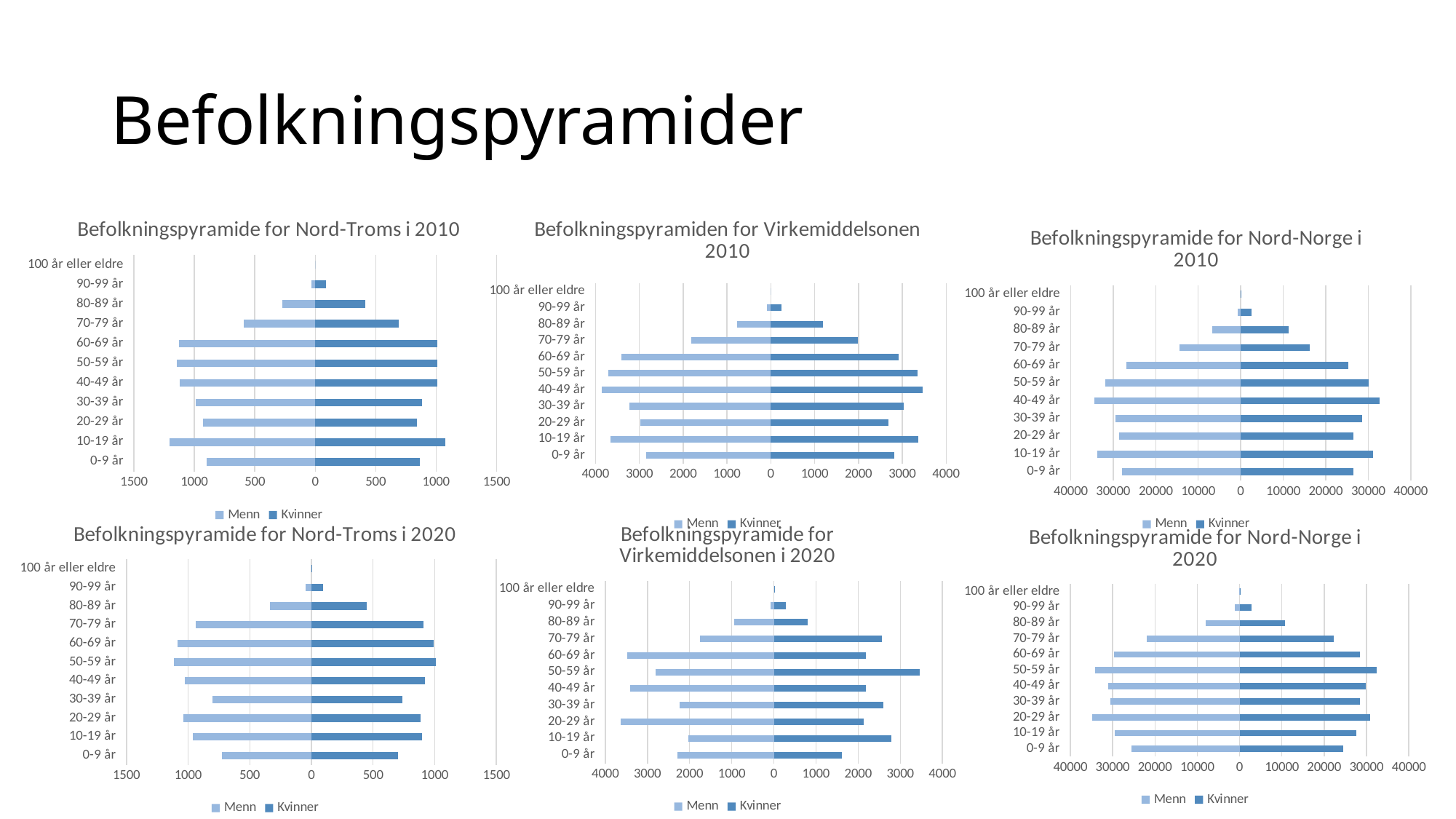
In "Befolkningspyramide for Virkemiddelsonen i 2020", which age group has the highest Kvinner value? 50-59 år How many age categories are shown on the y axis of "Befolkningspyramide for Nord-Troms i 2020"? 11 In "Befolkningspyramide for Nord-Norge i 2020", is the Kvinner value for 0-9 år greater or less than 30000? less How many charts are shown on the slide? 6 In "Befolkningspyramiden for Virkemiddelsonen 2010", which age group has the highest Kvinner value? 40-49 år How many series does the legend list in "Befolkningspyramide for Nord-Norge i 2020"? 2 In "Befolkningspyramide for Nord-Troms i 2010", is the Menn value for 80-89 år greater or less than 500? less In "Befolkningspyramide for Nord-Norge i 2010", is the Kvinner value for 40-49 år greater or less than 30000? greater What kind of chart is "Befolkningspyramide for Nord-Troms i 2010"? bar chart In "Befolkningspyramide for Nord-Troms i 2010", which age group has the highest Kvinner value? 10-19 år